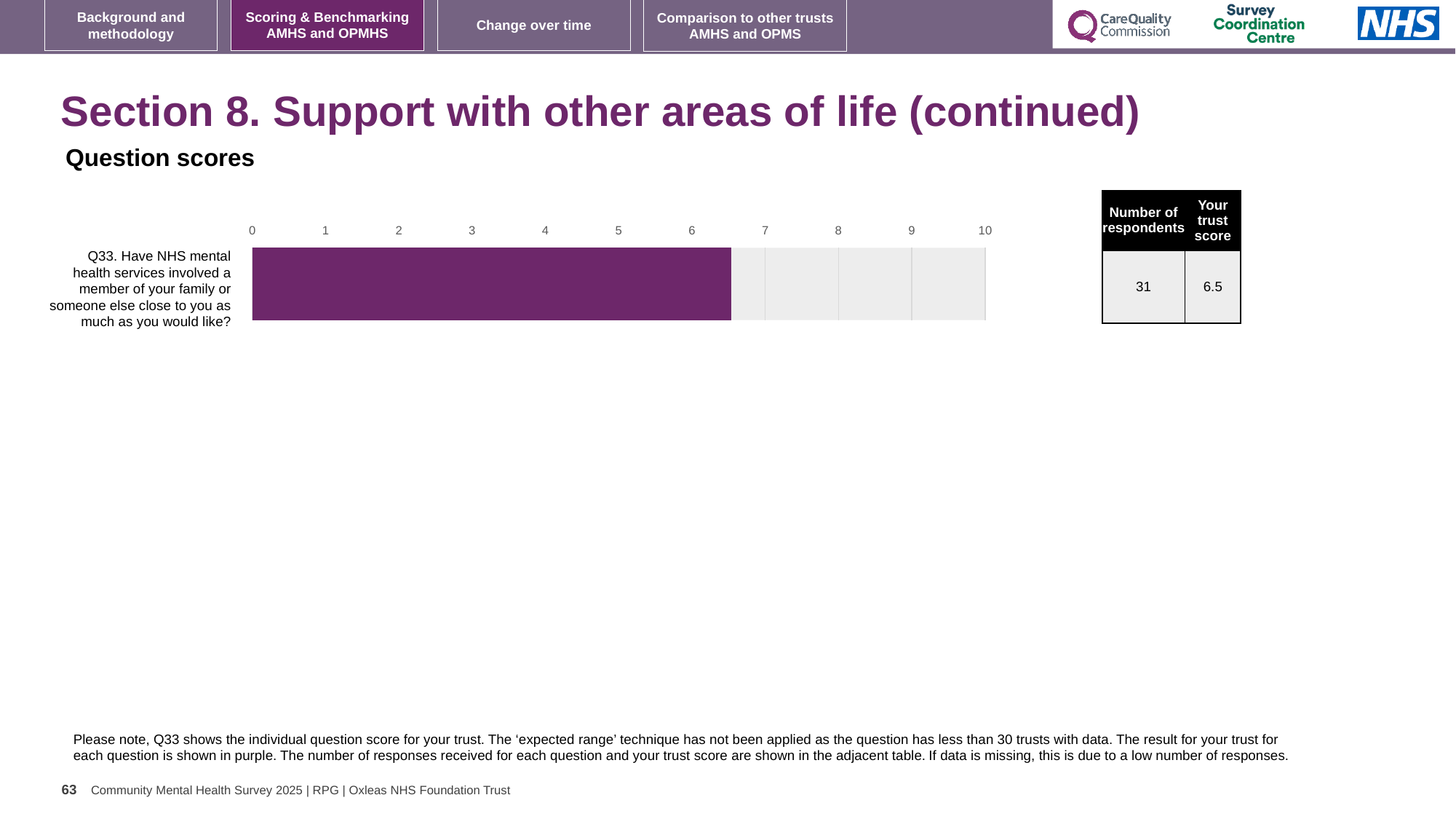
Is the value for Q33 greater or less than 7? less What is the maximum value shown on the chart's horizontal axis? 10 Is the value for Q33 greater or less than 5? greater What is the trust score for Q33 shown in the chart? 6.5 What colour is the bar showing the trust's score for Q33? purple How many questions (bars) are plotted on the chart? 1 How many respondents answered Q33 according to the table next to the chart? 31 Is the value for Q33 greater or less than 6? greater What kind of chart is used to show the Q33 score? bar chart